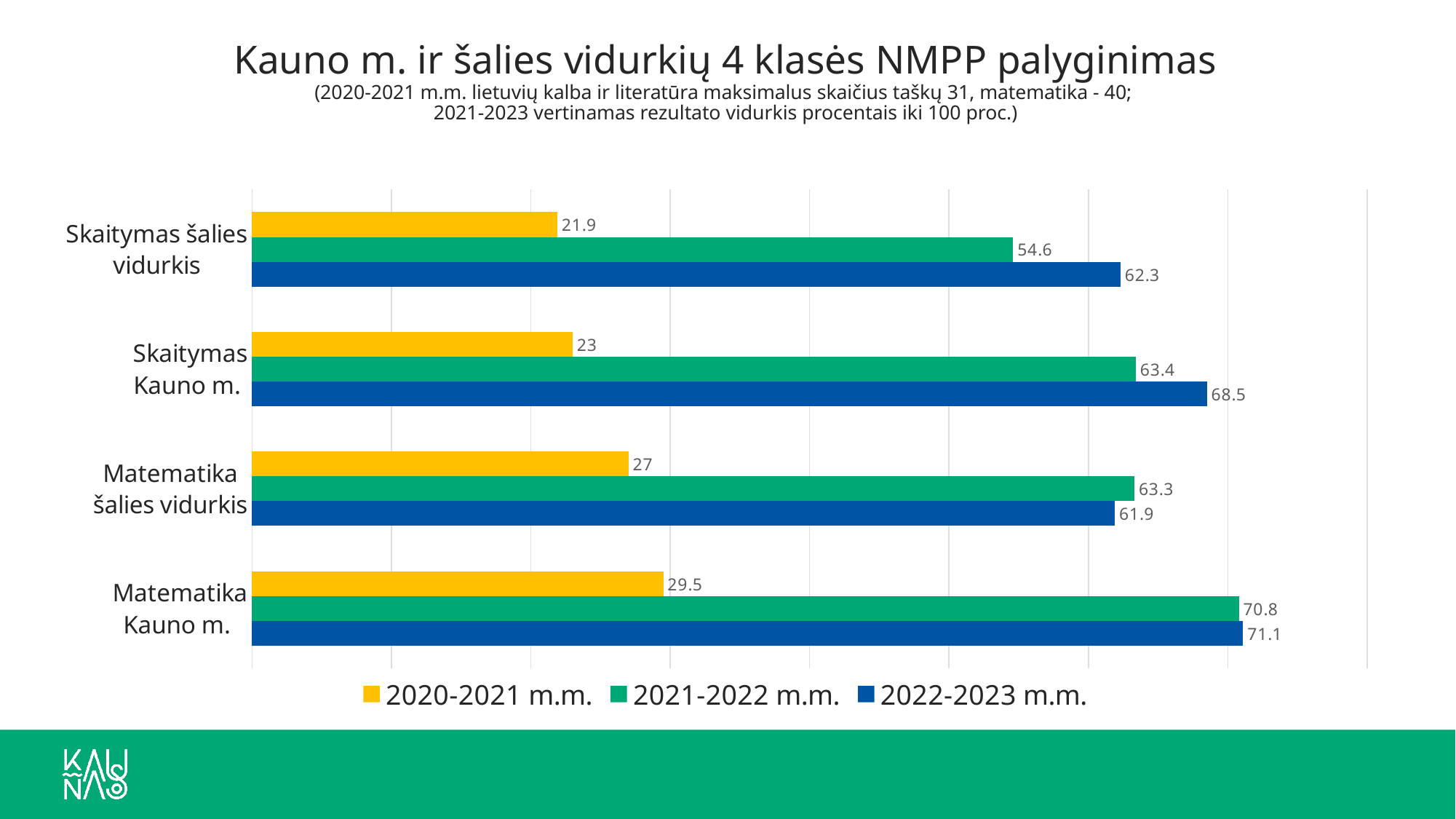
What kind of chart is shown on the slide? Bar chart What is the value for Matematika Kauno m. in 2020-2021 m.m.? 29.5 How many categories are shown on the chart? 4 Which colour represents the 2020-2021 m.m. series in the legend? Yellow Which is larger for Matematika šalies vidurkis: the 2021-2022 m.m. value or the 2022-2023 m.m. value? 2021-2022 m.m. Which category has the highest value in the 2022-2023 m.m. series? Matematika Kauno m. What is the difference between the 2021-2022 m.m. and 2020-2021 m.m. values for Matematika Kauno m.? 41.3 What is the value for Skaitymas šalies vidurkis in 2022-2023 m.m.? 62.3 What is the difference between Skaitymas Kauno m. and Skaitymas šalies vidurkis in 2022-2023 m.m.? 6.2 Which category has the lowest value in the 2020-2021 m.m. series? Skaitymas šalies vidurkis What is the value for Skaitymas Kauno m. in 2021-2022 m.m.? 63.4 How many series does the legend list? 3